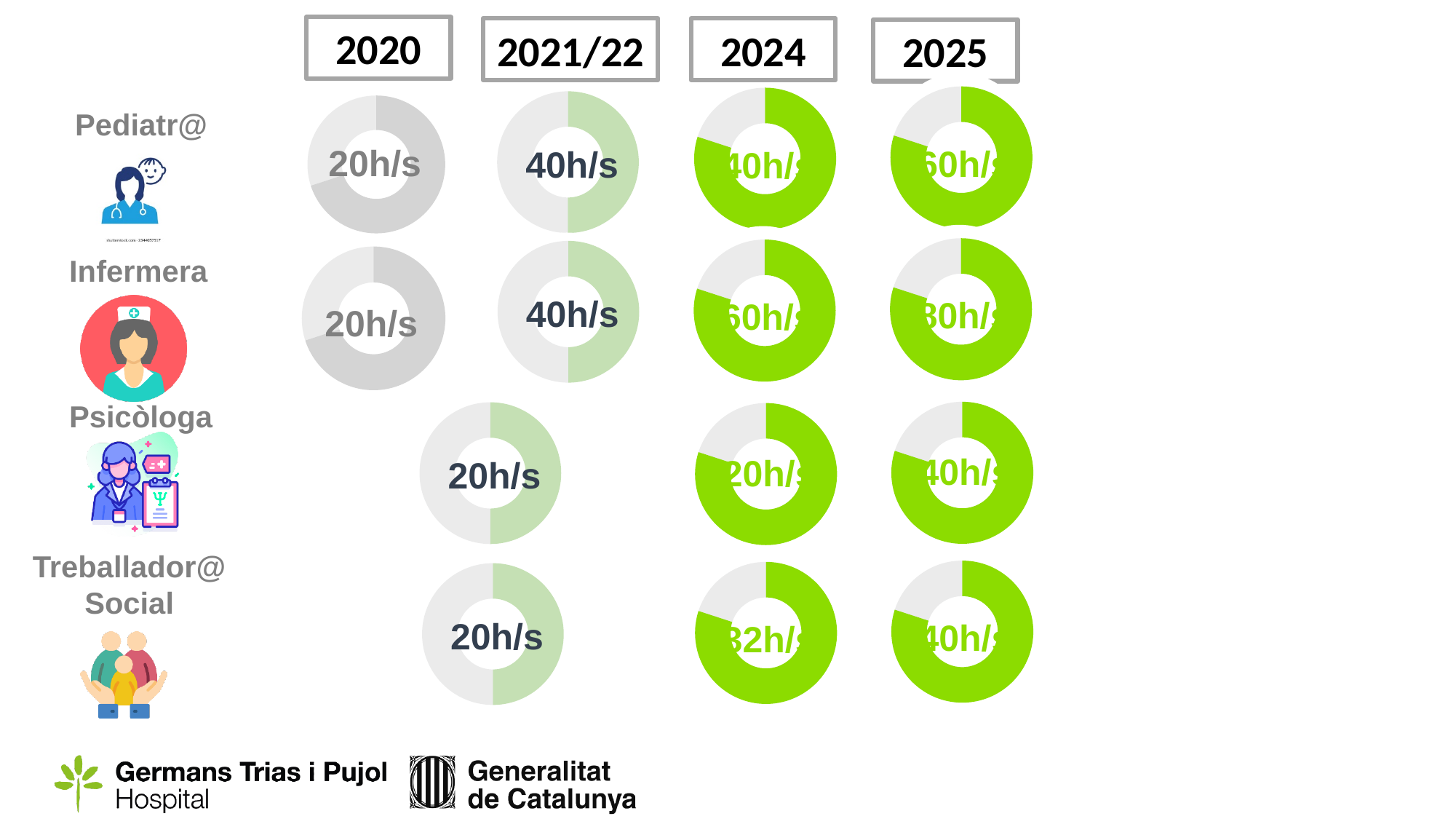
What is the difference between the Infermera value in 2021/22 and in 2020? 20h/s How many professional roles are listed on the slide? 4 Which is larger, the 2021/22 value for Pediatr@ or the 2021/22 value for Psicòloga? Pediatr@ What kind of charts are used on this slide? Donut charts Which two roles have no chart in the 2020 column? Psicòloga and Treballador@ Social What value is shown for Psicòloga in 2021/22? 20h/s What value is shown for Infermera in 2025? 80h/s What value is shown for Pediatr@ in 2020? 20h/s Do the values for Infermera rise or fall from 2020 to 2025? Rise How many year columns are shown on the slide? 4 What value is shown for Infermera in 2021/22? 40h/s What value is shown for Treballador@ Social in 2024? 32h/s